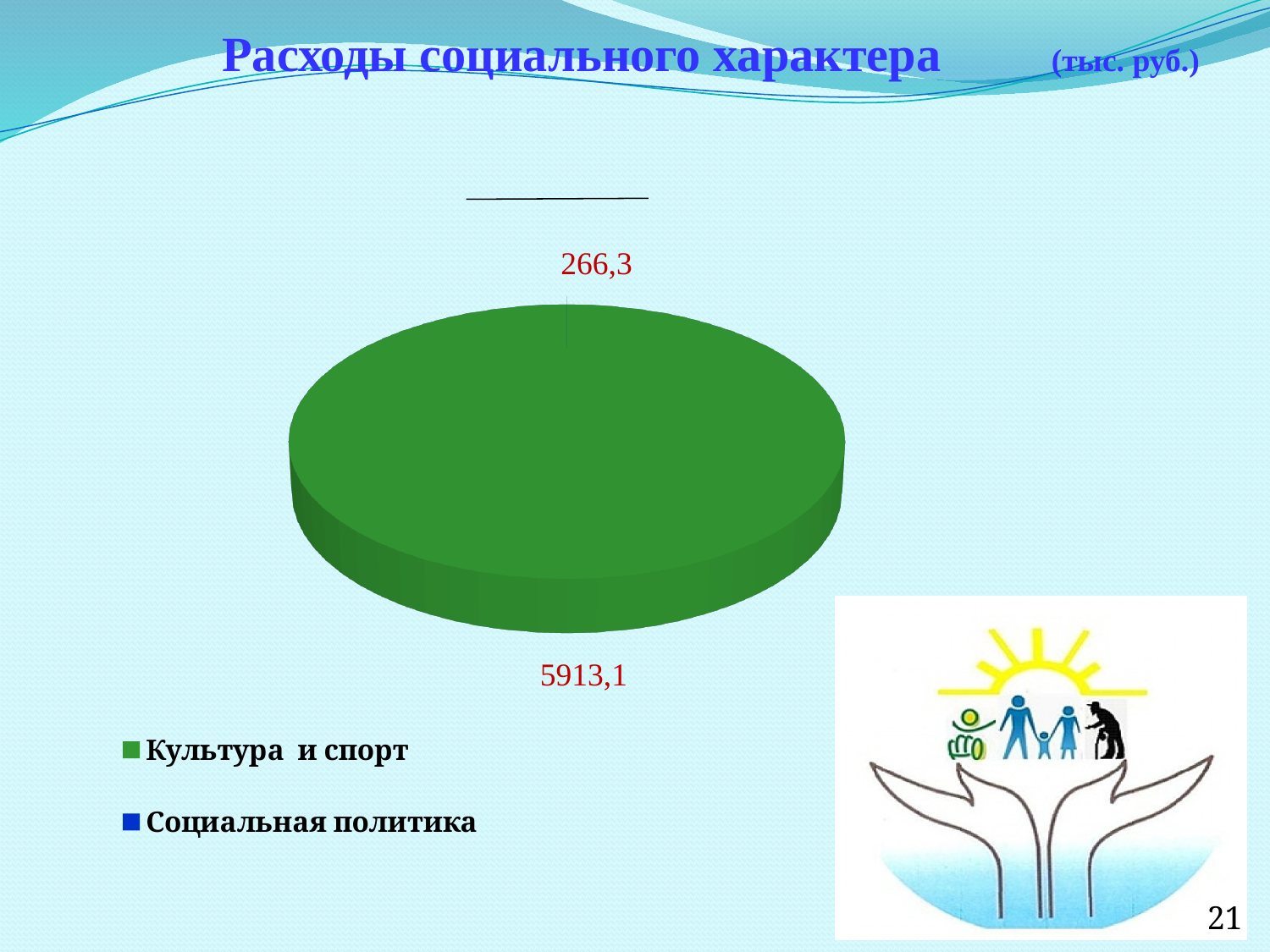
Which category has the smallest slice of the pie? Социальная политика Which is larger, the value for Культура и спорт or the value for Социальная политика? Культура и спорт Which category has the largest slice of the pie? Культура и спорт What is the total of the two values shown in the pie chart? 6179,4 What unit is given in the chart title? тыс. руб. What is the value for Социальная политика? 266,3 What is the value for Культура и спорт? 5913,1 What colour represents Культура и спорт in the legend? green What is the title of the chart on the slide? Расходы социального характера (тыс. руб.) What is the difference between the value for Культура и спорт and the value for Социальная политика? 5646,8 How many categories does the legend of the pie chart list? 2 What kind of chart is shown on the slide? pie chart